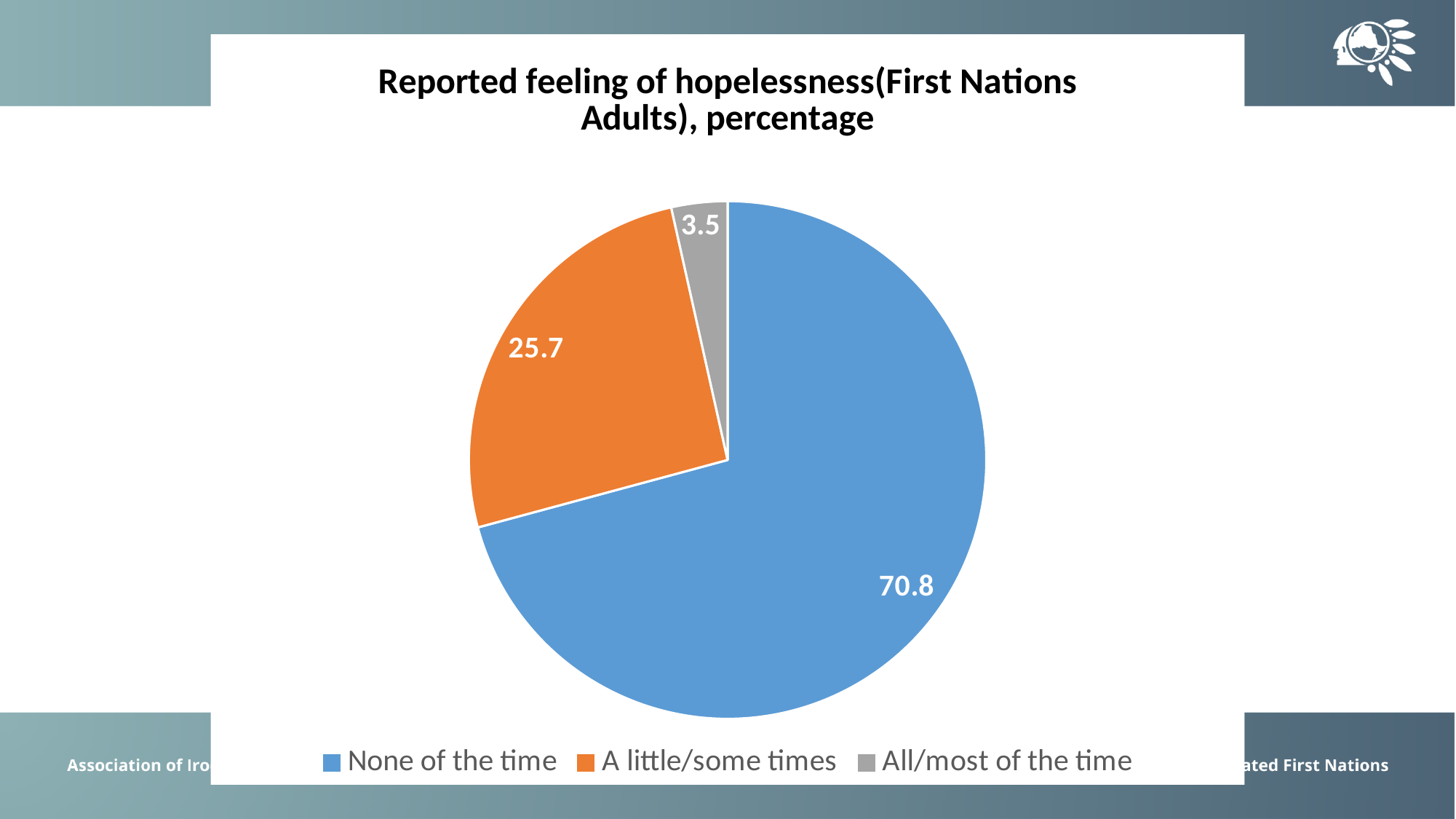
Which category has the smallest slice? All/most of the time What is the value for "None of the time"? 70.8 What is the difference between the values for "A little/some times" and "All/most of the time"? 22.2 How many slices does the pie chart have? 3 Which is larger, the value for "A little/some times" or the value for "All/most of the time"? A little/some times What is the value for "A little/some times"? 25.7 What is the title of the chart? Reported feeling of hopelessness(First Nations Adults), percentage What is the difference between the values for "None of the time" and "A little/some times"? 45.1 What kind of chart is shown on the slide? pie chart Which category has the largest slice? None of the time What is the value for "All/most of the time"? 3.5 Which colour represents "A little/some times" in the legend? orange